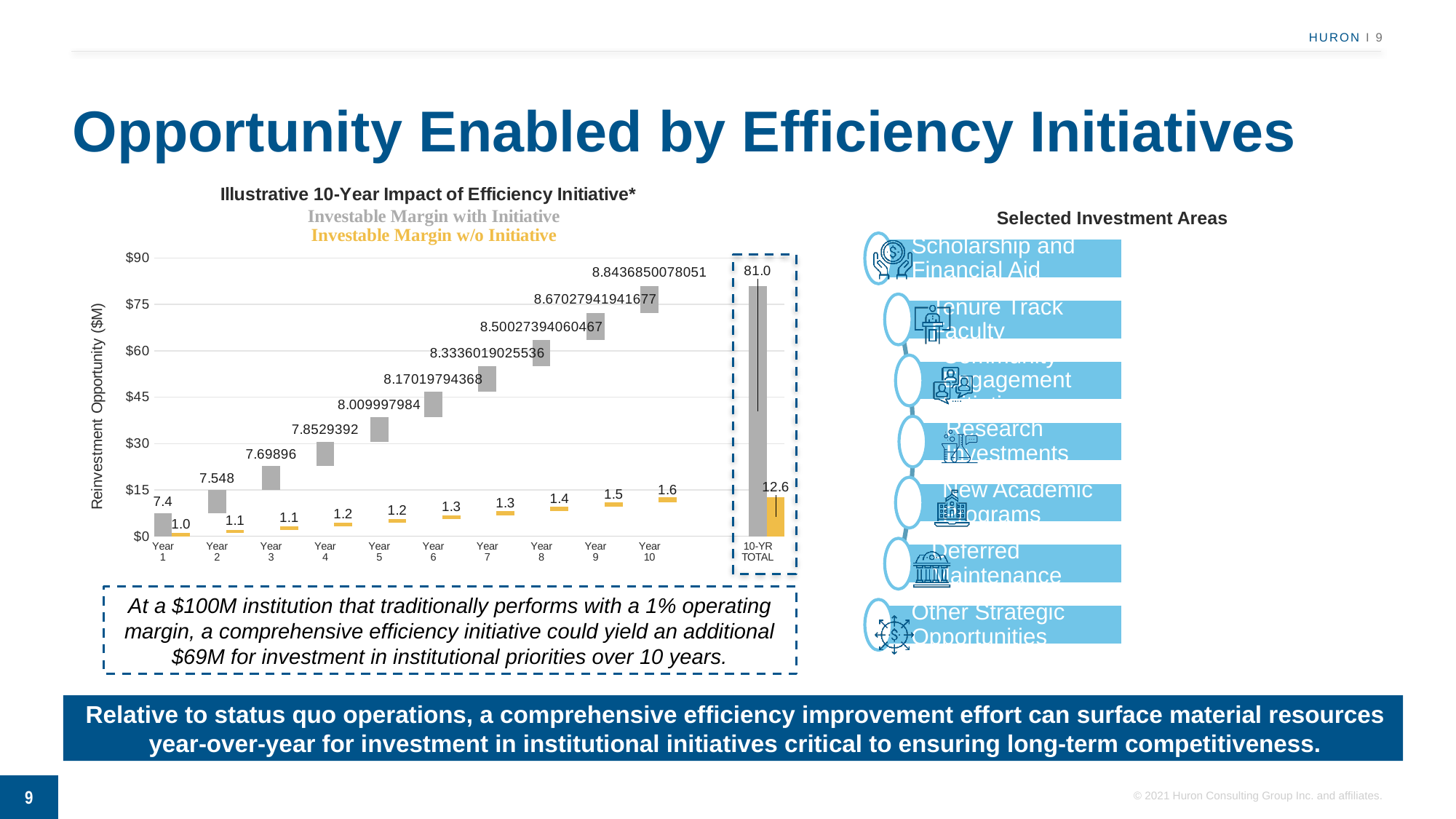
What is the Investable Margin with Initiative value for Year 1? 7.4 Do the Investable Margin w/o Initiative values rise or fall from Year 1 to Year 10? Rise Which year has the lowest Investable Margin w/o Initiative value? Year 1 How many series does the chart's legend list? 2 What is the Investable Margin w/o Initiative value for Year 10? 1.6 What is the 10-YR TOTAL value for Investable Margin w/o Initiative? 12.6 What type of chart is used to show the 10-year impact of the efficiency initiative? Bar chart What is the Investable Margin w/o Initiative value for Year 5? 1.2 What is the title of the chart on the slide? Illustrative 10-Year Impact of Efficiency Initiative* What is the 10-YR TOTAL value for Investable Margin with Initiative? 81.0 Which is larger in Year 8: Investable Margin with Initiative or Investable Margin w/o Initiative? Investable Margin with Initiative What is the difference between the 10-YR TOTAL values for Investable Margin with Initiative and w/o Initiative? 68.4